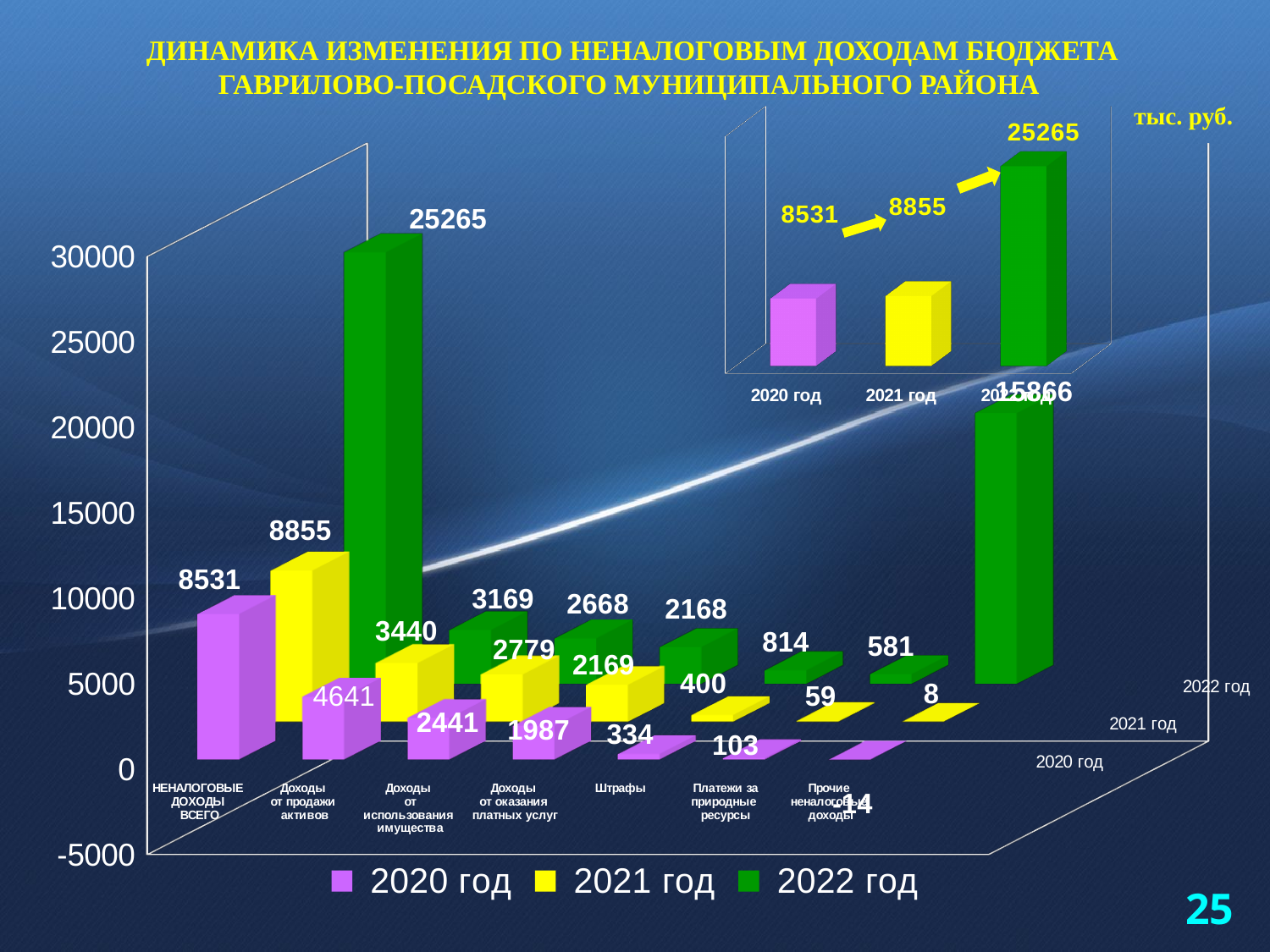
In the main chart, what is the value of НЕНАЛОГОВЫЕ ДОХОДЫ ВСЕГО for 2021 год? 8855 What unit is indicated for the values on the slide? тыс. руб. In the inset chart at the top right, do the values rise or fall from 2020 год to 2022 год? rise In the main chart, what is the value of НЕНАЛОГОВЫЕ ДОХОДЫ ВСЕГО for 2020 год? 8531 In the inset chart at the top right, which year has the highest value? 2022 год In the inset chart at the top right, what is the difference between the 2022 год value and the 2020 год value? 16734 Which series are listed in the legend of the main chart? 2020 год, 2021 год, 2022 год In the inset chart at the top right, which year has the lowest value? 2020 год In the main chart, is the value of НЕНАЛОГОВЫЕ ДОХОДЫ ВСЕГО for 2022 год greater or less than 20000? greater How many series does the legend of the main chart list? 3 In the main chart, what is the value of НЕНАЛОГОВЫЕ ДОХОДЫ ВСЕГО for 2022 год? 25265 What type of chart is the main chart on the slide? bar chart